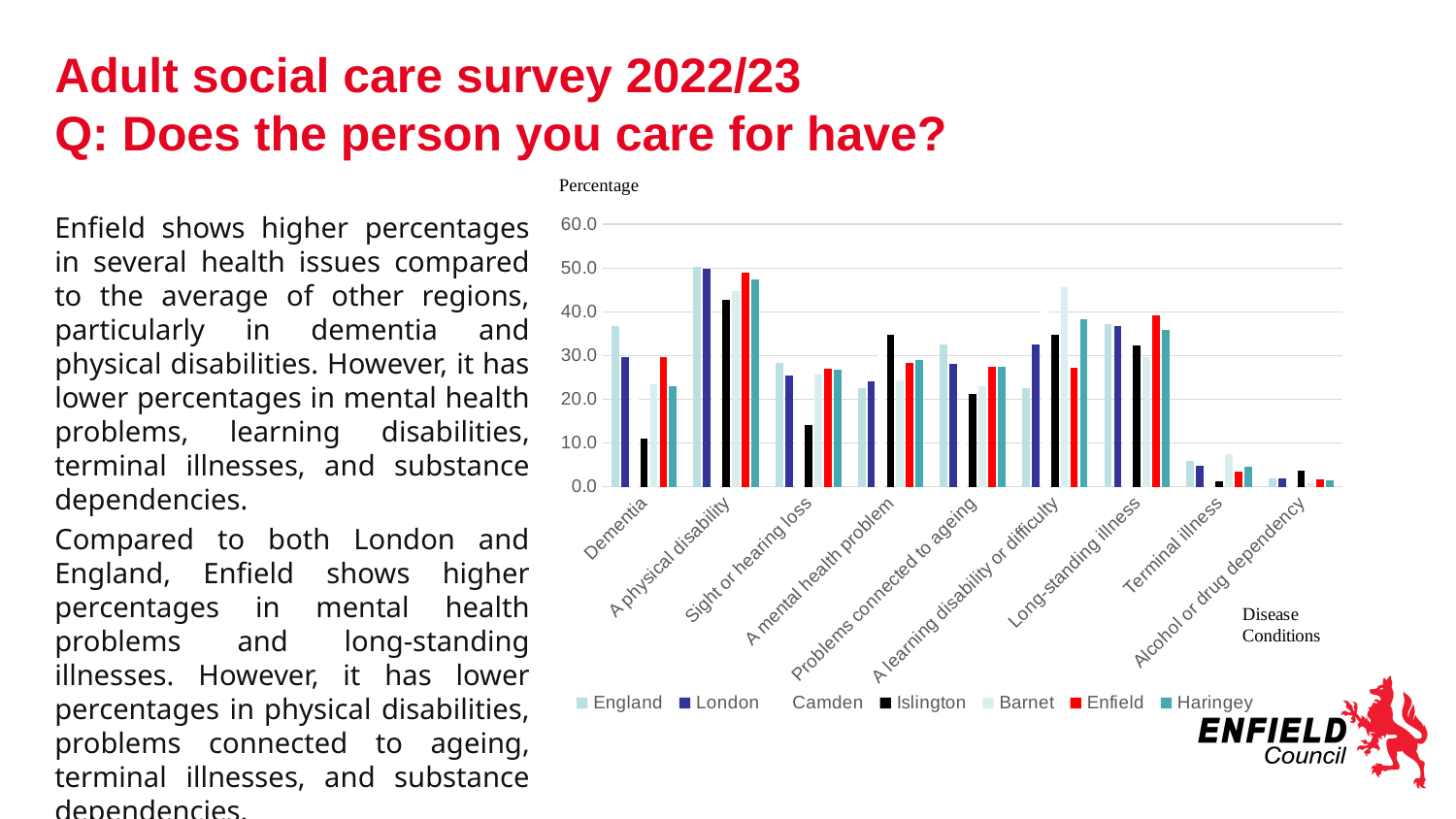
In the 'Dementia' category, which is larger: the value for England or the value for Enfield? England What kind of chart is shown on the slide? Bar chart Which disease condition has the lowest values across all regions? Alcohol or drug dependency Is the value for Islington in the 'Sight or hearing loss' category greater or less than 20? less Is the value for Enfield in the 'A physical disability' category greater or less than 40? greater Is the value for Enfield in the 'Terminal illness' category greater or less than 10? less How many disease condition categories are shown on the x axis of the chart? 9 Which disease condition has the highest value for Enfield? A physical disability In the 'A mental health problem' category, which is larger: the value for Islington or the value for Enfield? Islington What is the label on the vertical axis of the chart? Percentage How many series does the chart's legend list? 7